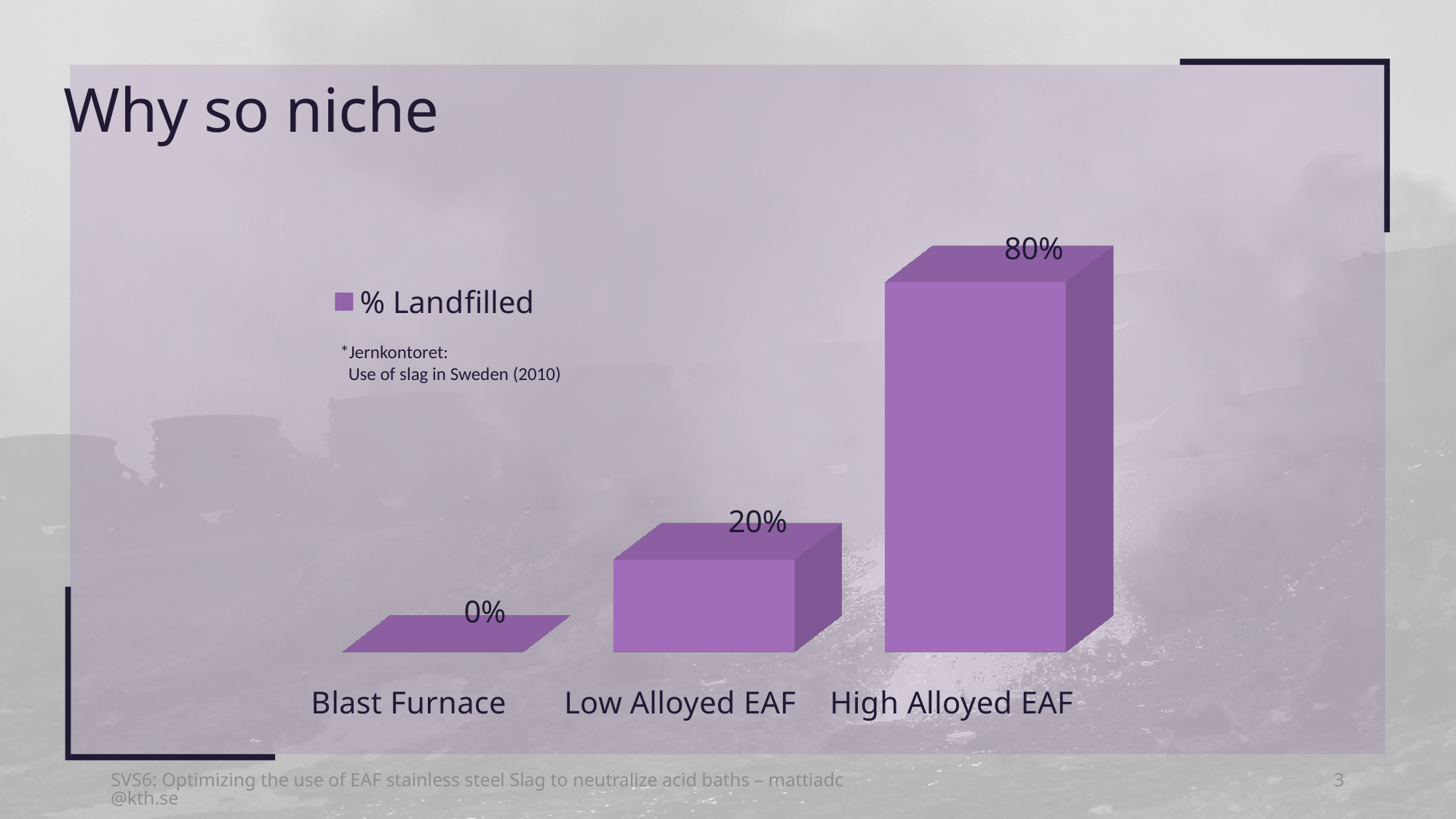
Which has a higher % Landfilled, Low Alloyed EAF or High Alloyed EAF? High Alloyed EAF Which category has the lowest % Landfilled? Blast Furnace How many categories are shown in the chart? 3 What kind of chart is shown on the slide? Bar chart What is the difference in % Landfilled between Low Alloyed EAF and Blast Furnace? 20% Which category has the highest % Landfilled? High Alloyed EAF What is the % Landfilled value for Low Alloyed EAF? 20% What is the % Landfilled value for High Alloyed EAF? 80% How many series does the legend list? 1 What is the % Landfilled value for Blast Furnace? 0% Do the values rise or fall from left to right across the categories? Rise What is the difference in % Landfilled between High Alloyed EAF and Low Alloyed EAF? 60%